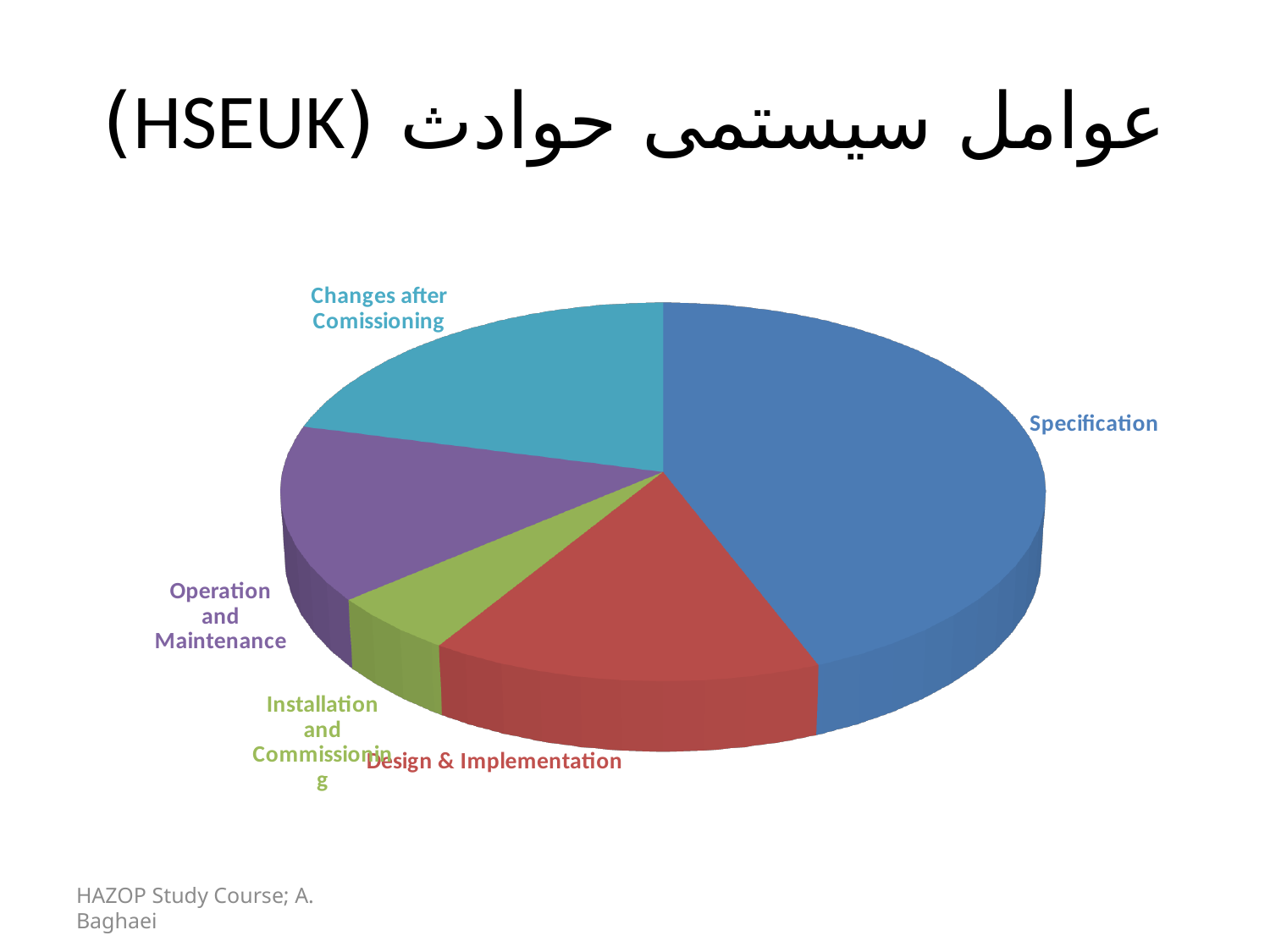
Which slice is larger: Specification or Changes after Comissioning? Specification How many slices does the pie chart have? 5 Which category is shown in green on the pie chart? Installation and Commissioning What kind of chart is shown on the slide? pie chart Which slice is larger: Operation and Maintenance or Installation and Commissioning? Operation and Maintenance Which category has the smallest slice of the pie chart? Installation and Commissioning Which category has the largest slice of the pie chart? Specification What colour is the Specification slice of the pie chart? blue Which slice is larger: Changes after Comissioning or Installation and Commissioning? Changes after Comissioning